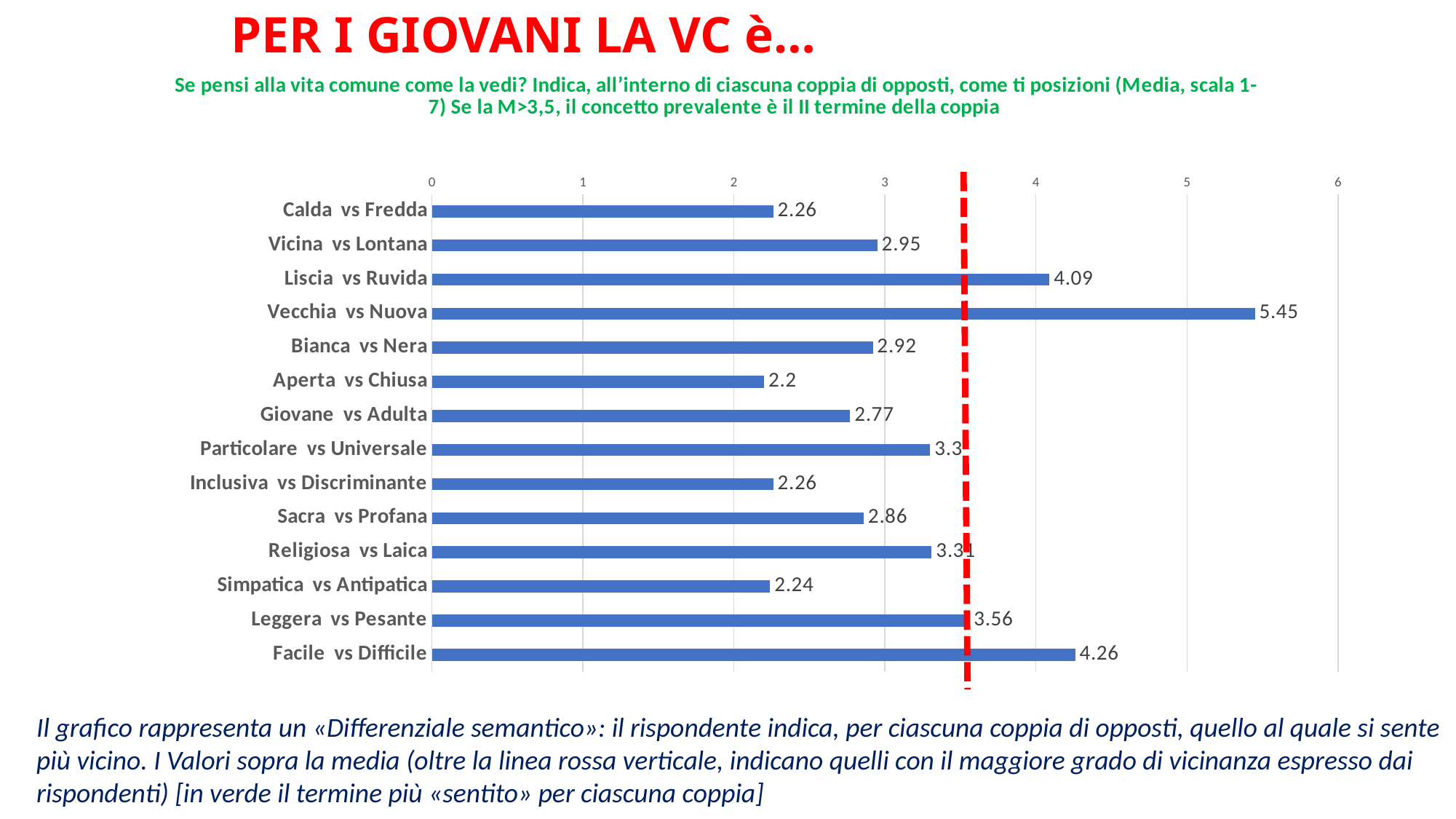
What is the value for Vecchia vs Nuova? 5.45 Is the value for Sacra vs Profana greater or less than 3? less What is the difference between the values for Vecchia vs Nuova and Facile vs Difficile? 1.19 What kind of chart is shown on the slide? Bar chart What is the value for Leggera vs Pesante? 3.56 Which category has the highest value? Vecchia vs Nuova What is the value for Facile vs Difficile? 4.26 Which category has the lowest value? Aperta vs Chiusa Which is larger, the value for Liscia vs Ruvida or the value for Vicina vs Lontana? Liscia vs Ruvida What is the value for Aperta vs Chiusa? 2.2 How many categories are shown in the chart? 14 What is the value for Calda vs Fredda? 2.26